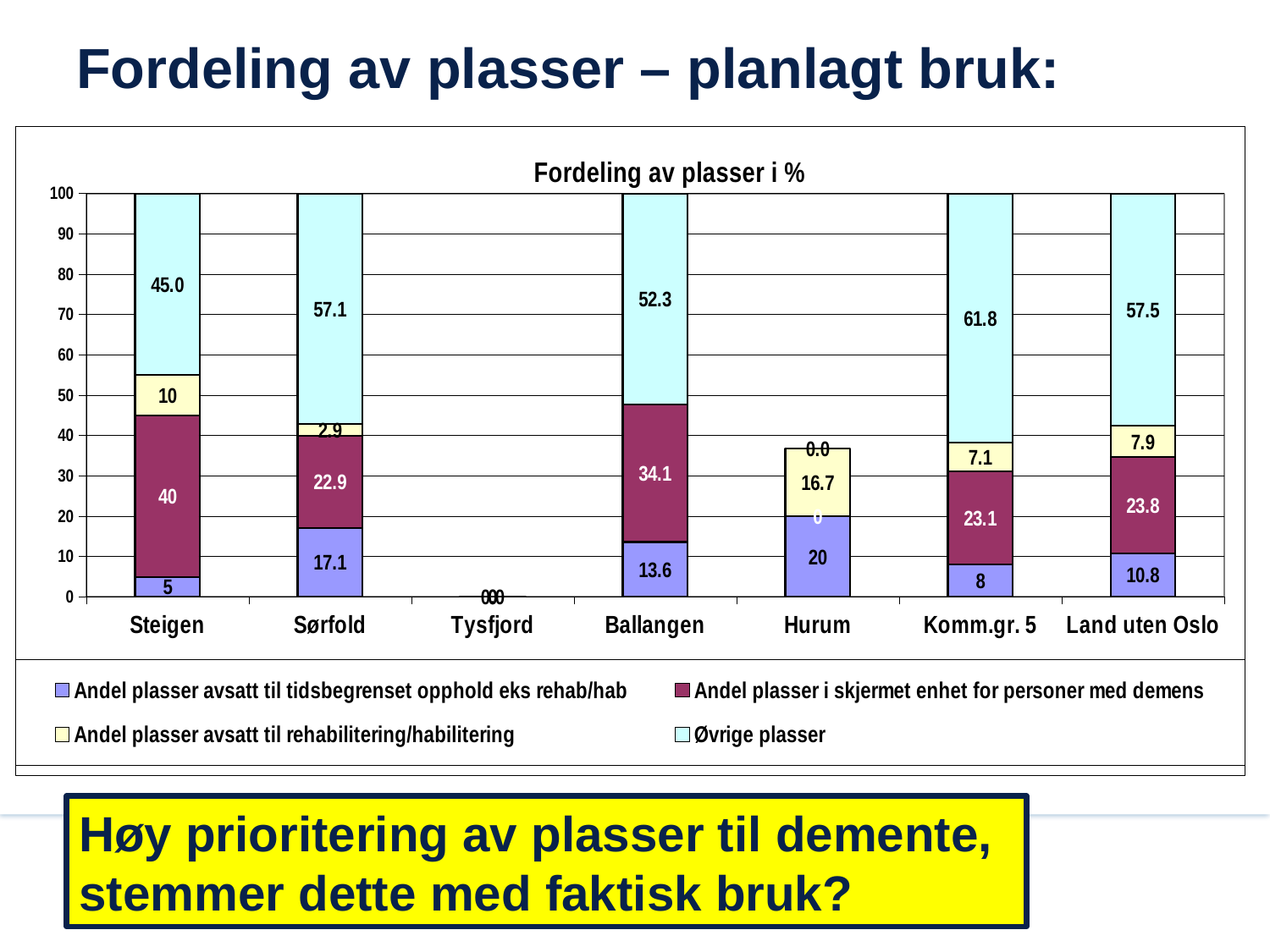
What kind of chart is shown on the slide? stacked bar chart Which category has the highest value for 'Andel plasser i skjermet enhet for personer med demens'? Steigen What is the value of 'Andel plasser avsatt til rehabilitering/habilitering' for Hurum? 16.7 How many categories are shown along the x axis of the chart? 7 What is the value of 'Andel plasser i skjermet enhet for personer med demens' for Steigen? 40 Which is larger: the 'Andel plasser i skjermet enhet for personer med demens' value for Ballangen or for Komm.gr. 5? Ballangen What is the value of 'Andel plasser avsatt til tidsbegrenset opphold eks rehab/hab' for Sørfold? 17.1 Which category has the highest value for 'Øvrige plasser'? Komm.gr. 5 What is the value of 'Øvrige plasser' for Komm.gr. 5? 61.8 What is the title of the chart? Fordeling av plasser i % How many series does the legend list? 4 What is the difference between the 'Øvrige plasser' values for Land uten Oslo and Ballangen? 5.2